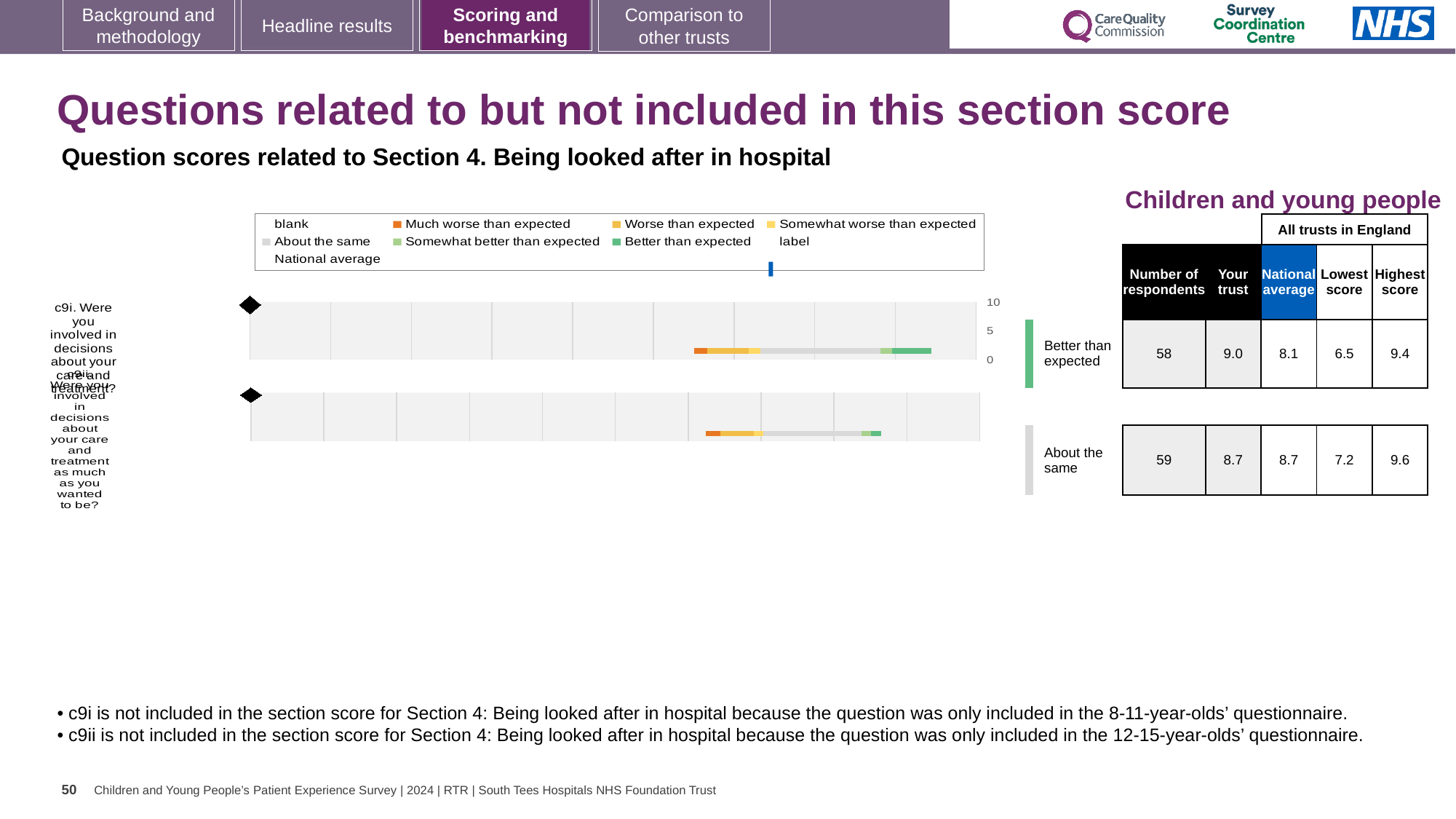
What is the highest score among all trusts in England for question c9i? 9.4 What is the national average score for question c9ii? 8.7 What is the highest value shown on the chart's score axis? 10 What kind of chart is shown on the slide? Bar chart For question c9i, which is larger: the 'Your trust' score or the national average? Your trust Which legend entry is shown in dark green? Better than expected How many questions (bars) are plotted in the chart? 2 What benchmark category is shown for question c9ii? About the same For question c9i, what is the difference between the 'Your trust' score and the national average? 0.9 How many respondents answered question c9ii? 59 What benchmark category is shown for question c9i? Better than expected What is the 'Your trust' score for question c9i? 9.0